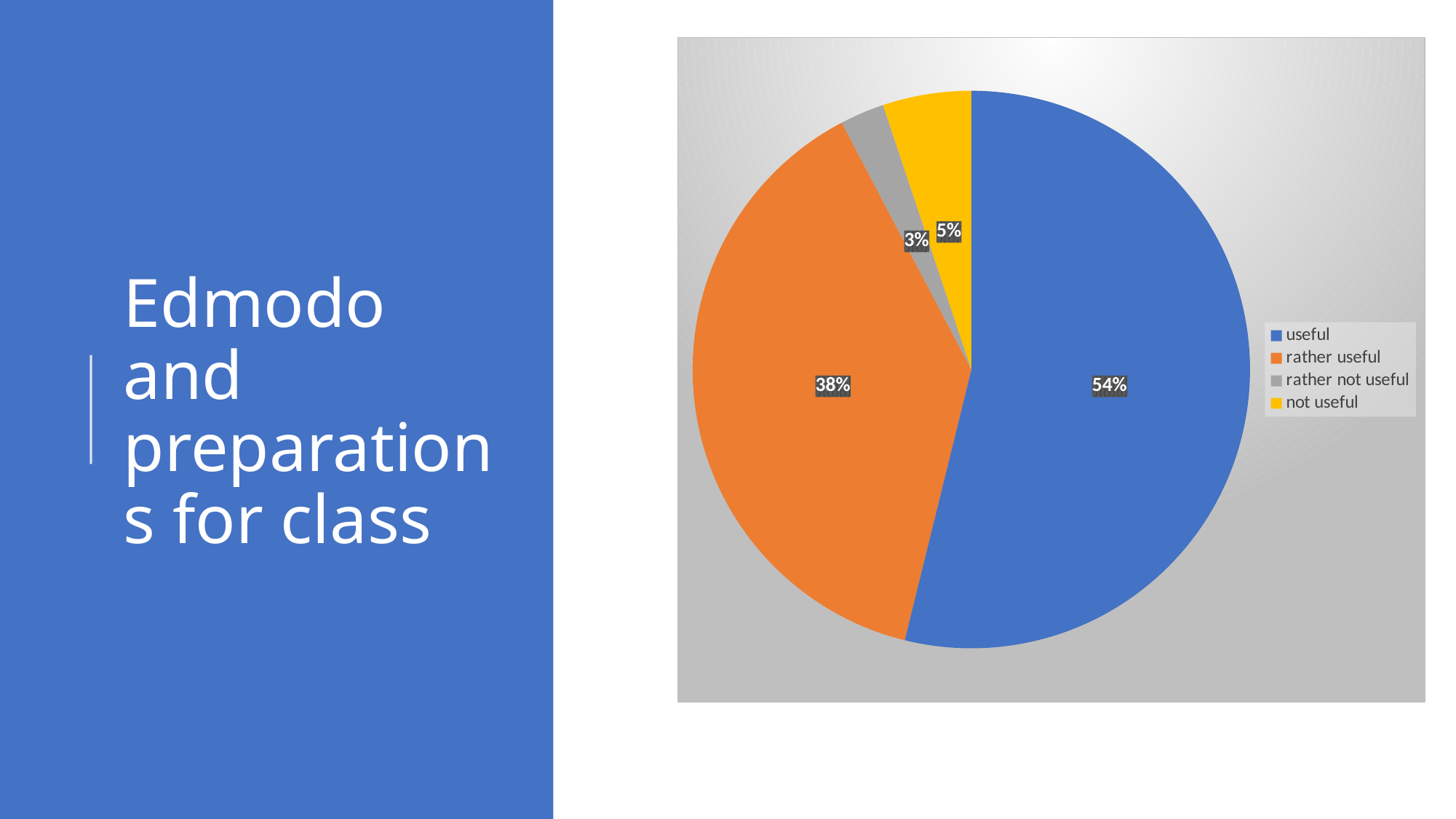
What share of the pie is labelled "useful"? 54% Which category has the largest slice of the pie? useful What is the combined share of the "useful" and "rather useful" slices? 92% What share of the pie is labelled "rather not useful"? 3% What kind of chart is shown on the slide? pie chart What share of the pie is labelled "not useful"? 5% Which category has the smallest slice of the pie? rather not useful What colour is the "rather useful" slice? orange How many categories does the pie chart have? 4 Which slice is larger, "not useful" or "rather not useful"? not useful What is the difference in percentage points between the "useful" and "rather useful" slices? 16